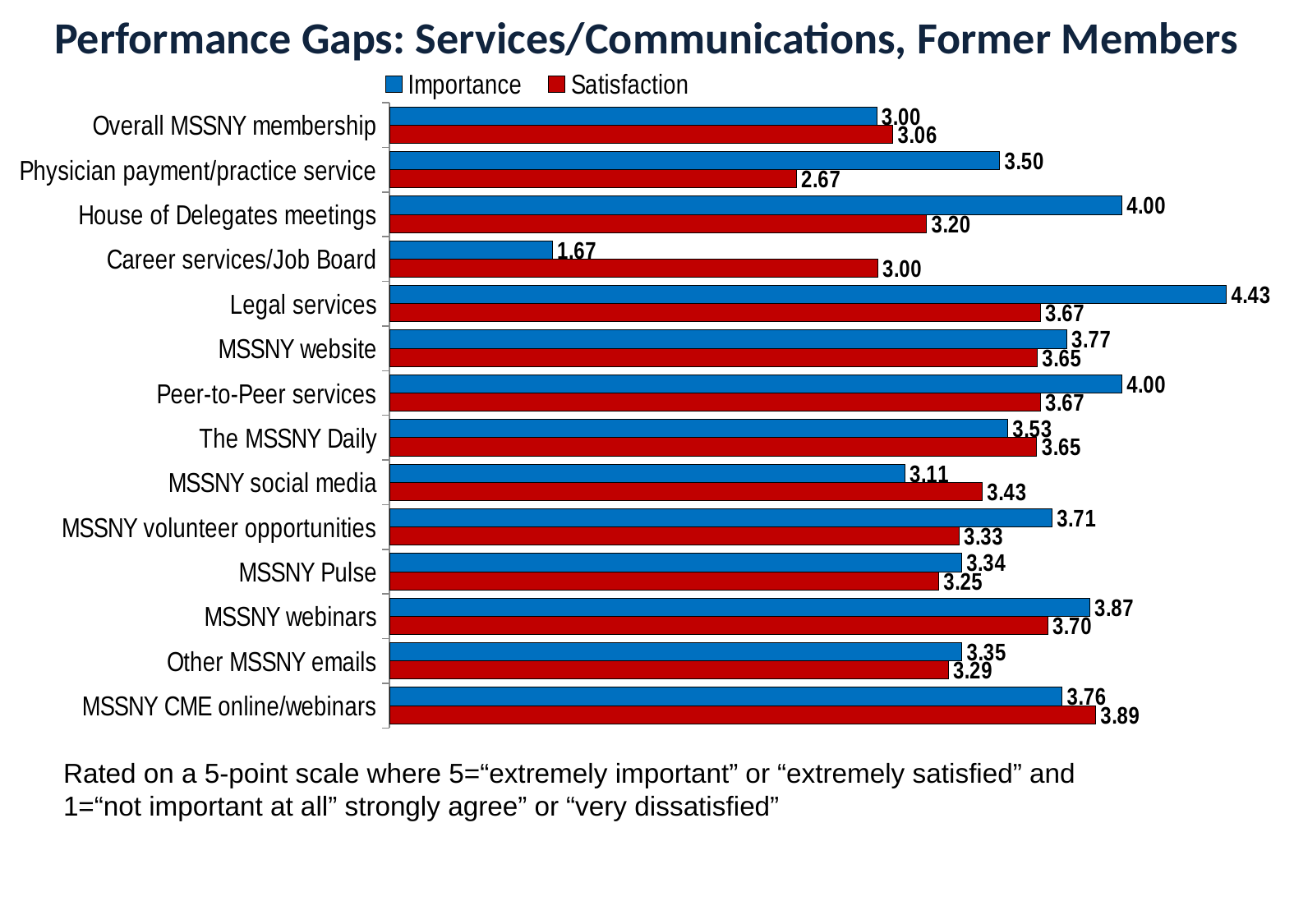
What is the Satisfaction value for Physician payment/practice service? 2.67 For MSSNY social media, which is larger: Importance or Satisfaction? Satisfaction Which category has the lowest Importance value? Career services/Job Board What is the difference between Importance and Satisfaction for House of Delegates meetings? 0.80 What is the Importance value for Legal services? 4.43 What is the Importance value for Career services/Job Board? 1.67 How many categories are shown on the chart? 14 What is the difference between Satisfaction and Importance for Career services/Job Board? 1.33 How many series does the legend list? 2 Which category has the lowest Satisfaction value? Physician payment/practice service What is the Satisfaction value for MSSNY CME online/webinars? 3.89 Which category has the highest Importance value? Legal services